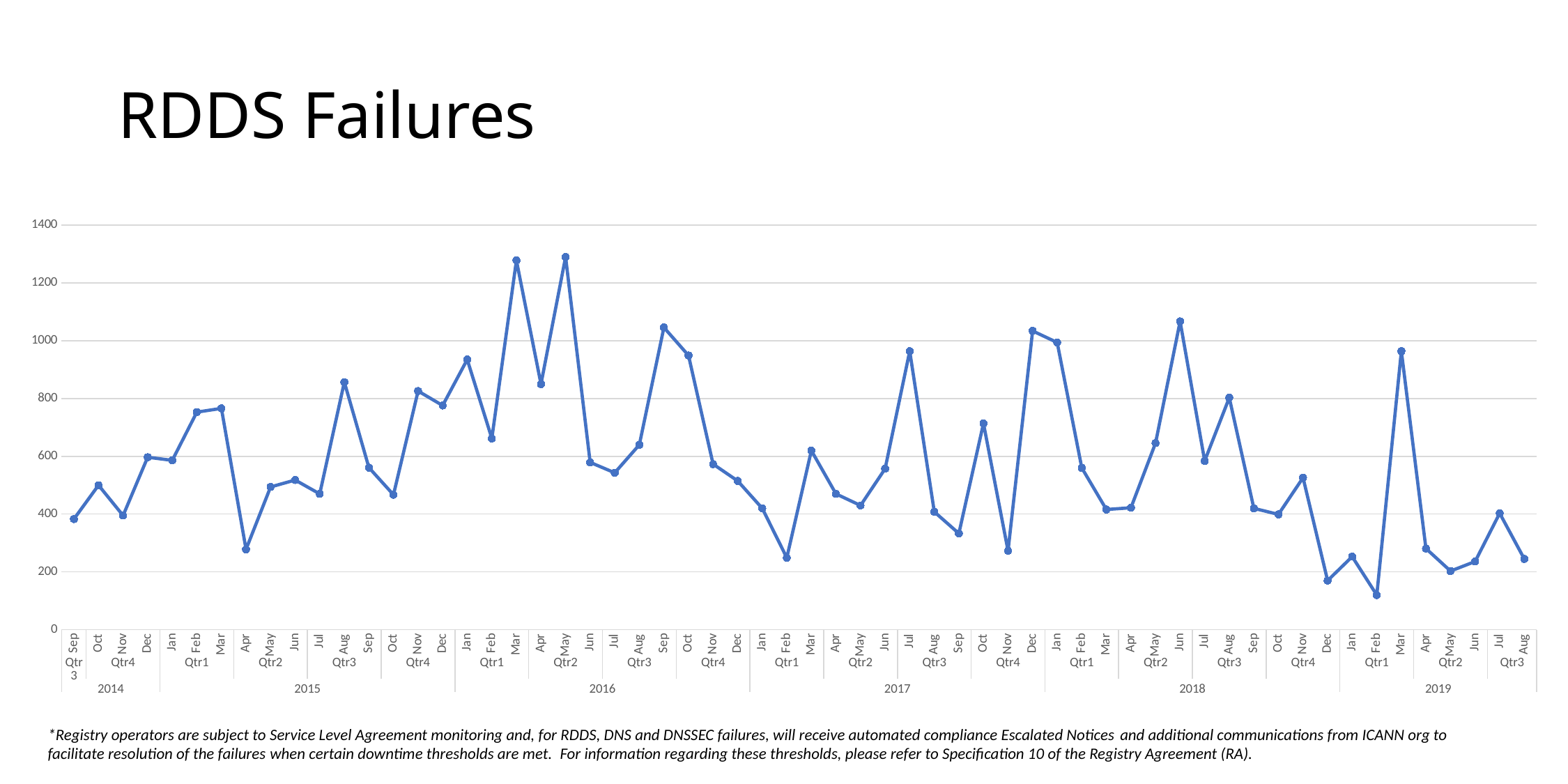
What is the title of the chart? RDDS Failures Is the value for Sep 2016 greater or less than 1000? greater Which is larger, the value for Jun 2018 or the value for Jul 2018? Jun 2018 What kind of chart is shown on the slide? line chart Is the value for Apr 2015 greater or less than 400? less Which is larger, the value for Sep 2014 or the value for Oct 2014? Oct 2014 Which month has the lowest value on the chart? Feb 2019 Is the value for Feb 2019 greater or less than 200? less Do the values rise or fall from Sep 2016 to Dec 2016? fall How many monthly data points are plotted on the chart? 60